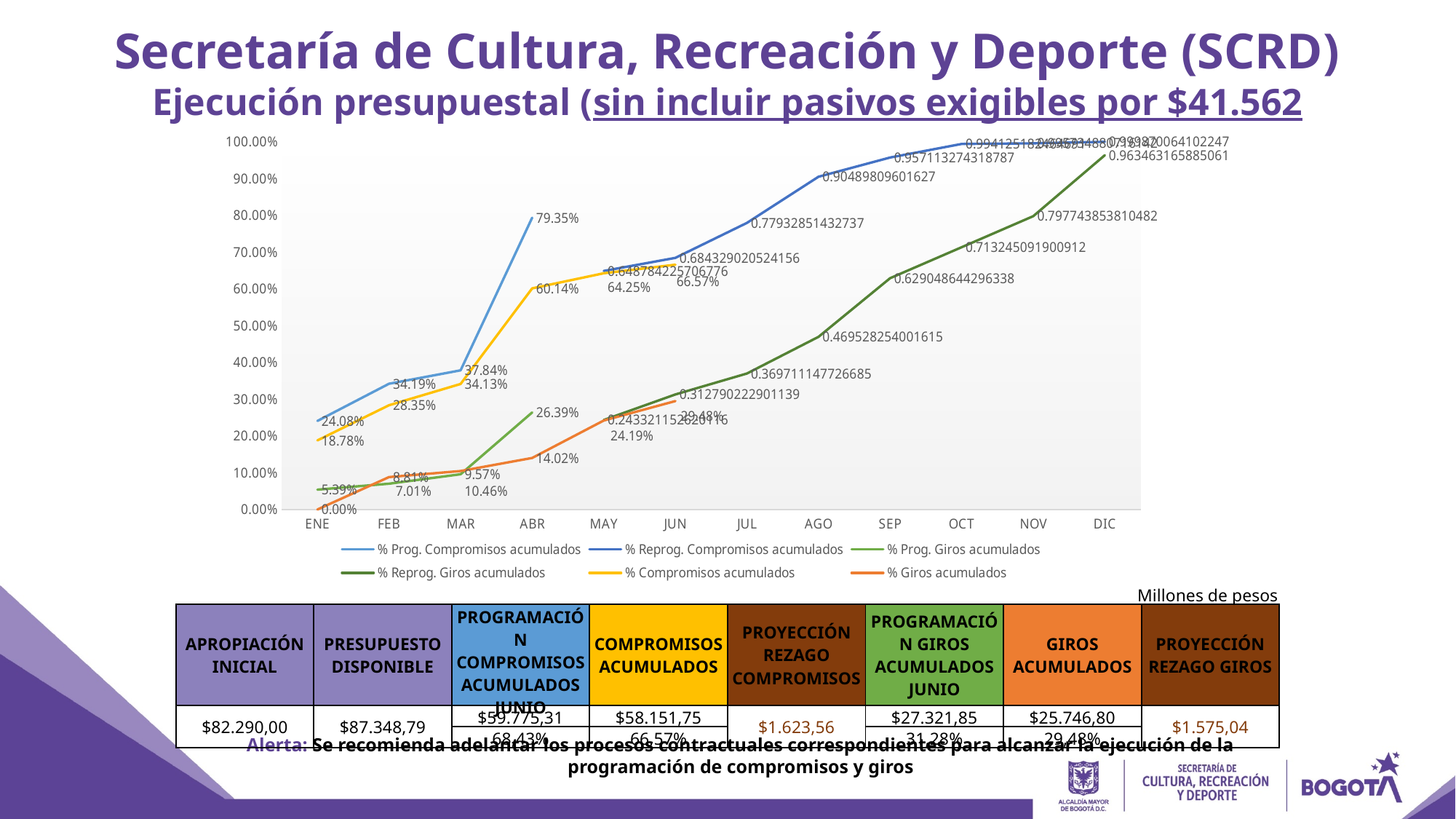
How many series does the chart legend list? 6 What is the value of % Prog. Compromisos acumulados in ABR? 79.35% Is the value of % Reprog. Giros acumulados in DIC greater or less than 90%? greater What is the value of % Compromisos acumulados in JUN? 66.57% What is the difference between % Prog. Compromisos acumulados and % Compromisos acumulados in ABR? 19.21 percentage points What is the value of % Giros acumulados in ENE? 0.00% What is the value of % Giros acumulados in JUN? 29.48% How many months are shown on the x axis of the chart? 12 Which is larger in MAR: % Prog. Compromisos acumulados or % Compromisos acumulados? % Prog. Compromisos acumulados What kind of chart is shown on the slide? Line chart In which month does % Compromisos acumulados reach its highest labelled value? JUN Does % Reprog. Giros acumulados rise or fall from MAY to DIC? Rises